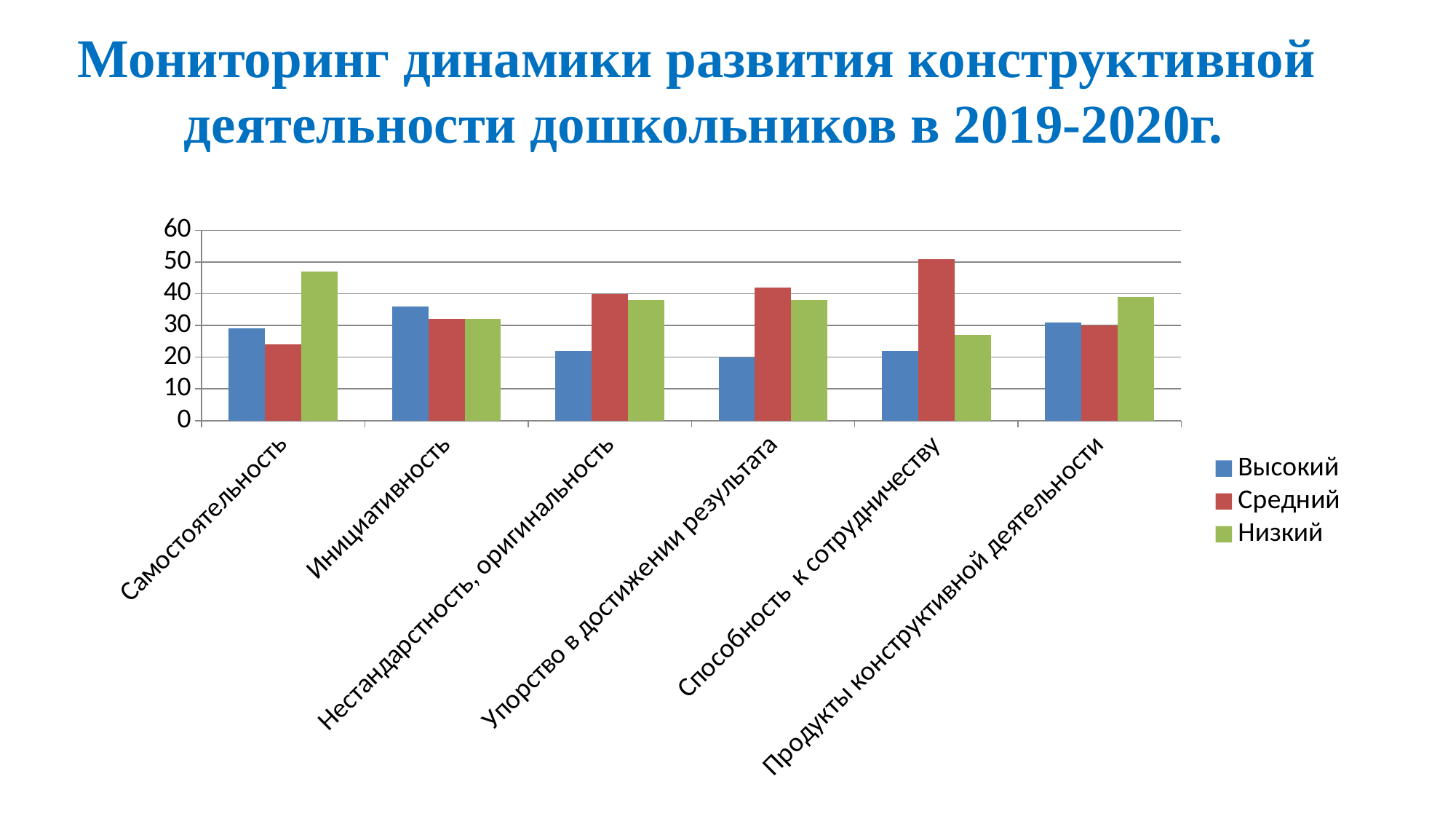
How many series does the chart legend list? 3 For Способность к сотрудничеству, which is larger: the Средний value or the Низкий value? Средний Which category has the highest value for the Высокий series? Инициативность What are the three series named in the chart legend? Высокий, Средний, Низкий For Самостоятельность, which is larger: the Высокий value or the Низкий value? Низкий How many categories are shown on the x axis of the chart? 6 Is the Низкий value for Самостоятельность greater or less than 40? greater Which category has the lowest value for the Средний series? Самостоятельность What kind of chart is shown on the slide? Bar chart Which category has the highest value for the Низкий series? Самостоятельность Which category has the highest value for the Средний series? Способность к сотрудничеству Is the Высокий value for Упорство в достижении результата greater or less than 30? less